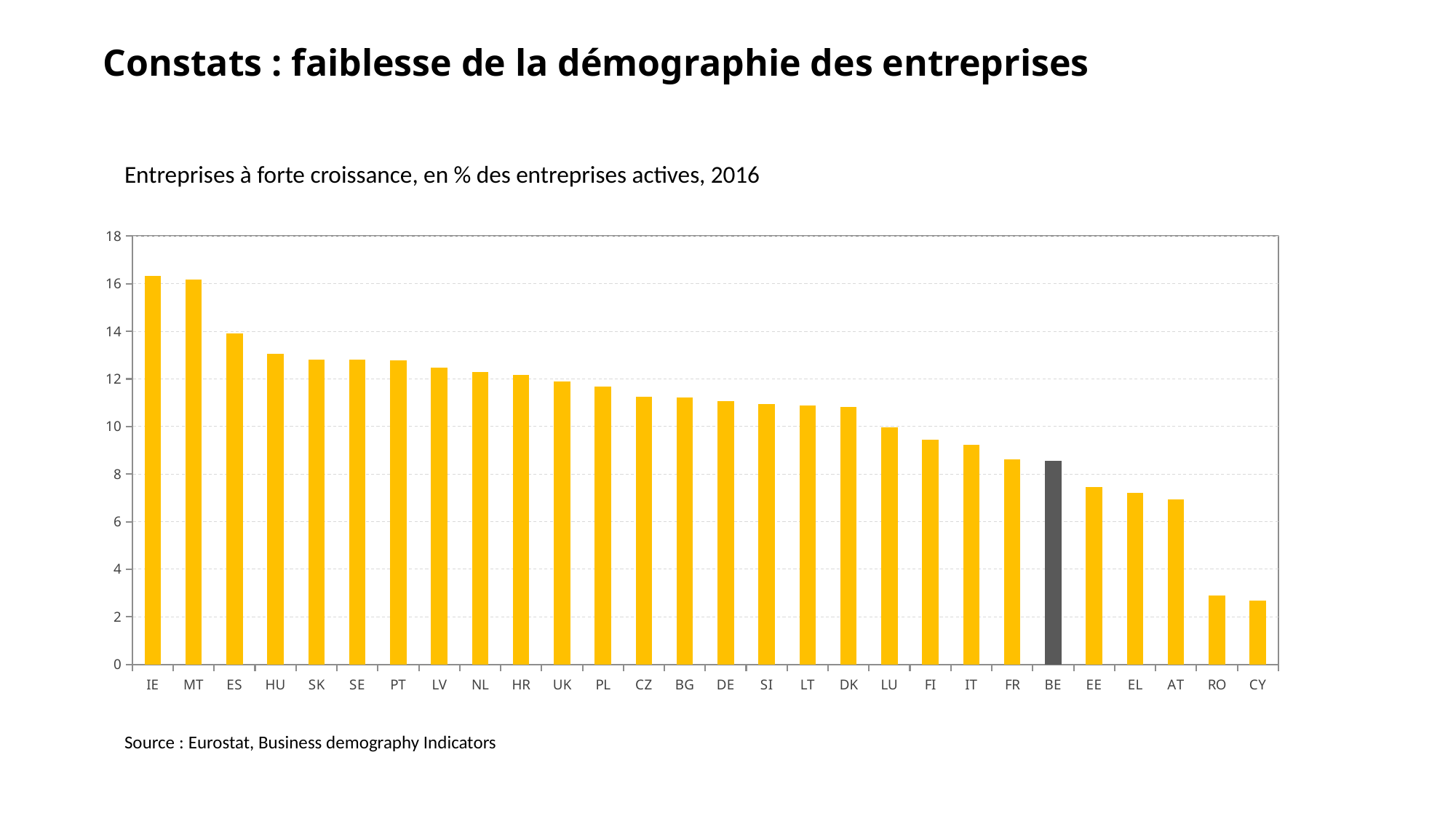
What is the title of the chart? Entreprises à forte croissance, en % des entreprises actives, 2016 Which has the larger value, ES or HU? ES How many countries are shown on the x axis of the chart? 28 Which has the larger value, BE or EE? BE Which country's bar is coloured dark grey instead of yellow? BE Is the value for CY greater or less than 4? less Do the values rise or fall moving from left to right along the x axis? fall What kind of chart is shown on the slide? bar chart Is the value for BE greater or less than 8? greater Is the value for IE greater or less than 16? greater